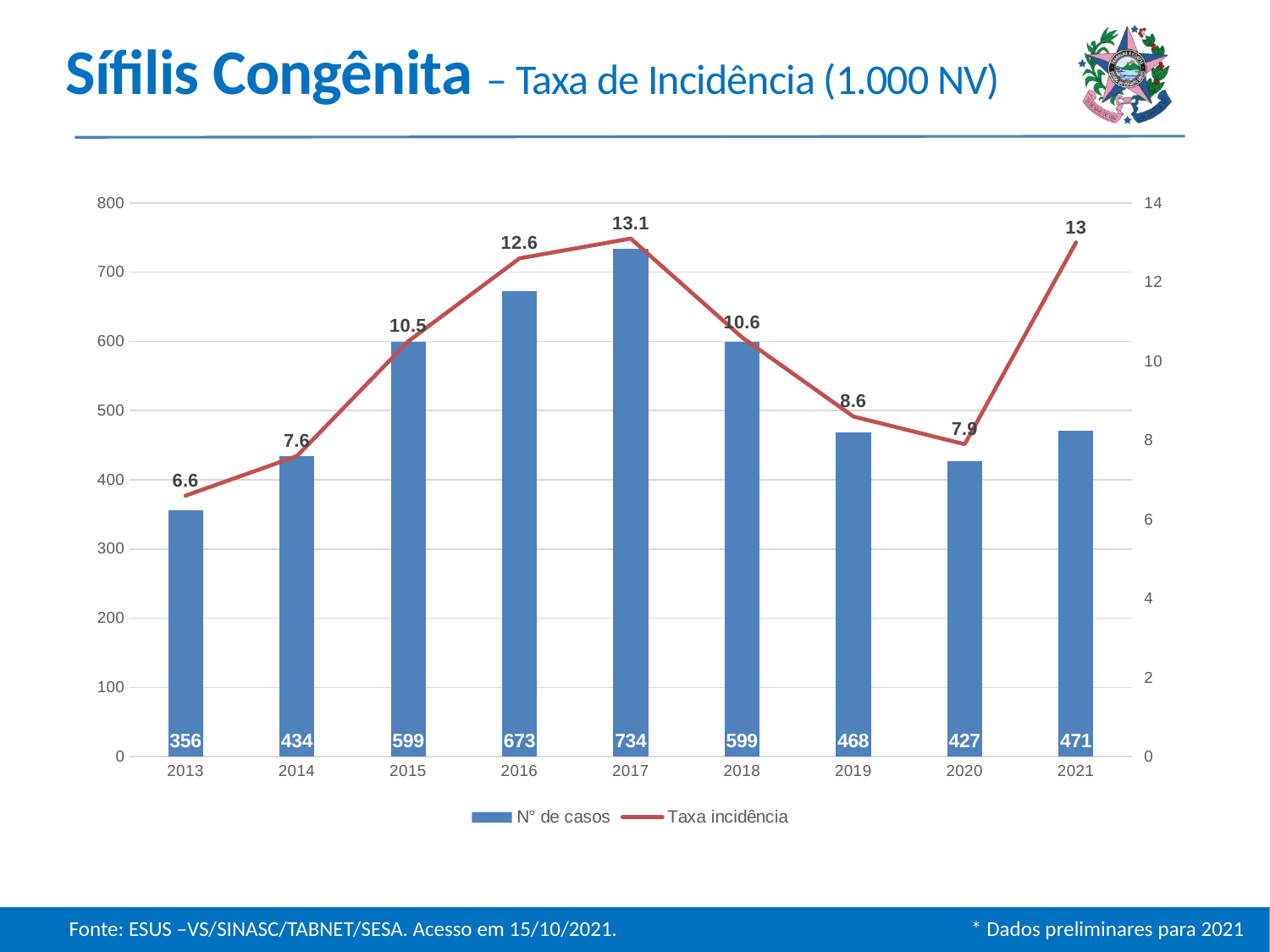
Which year has the highest number of cases? 2017 Which year has the lowest incidence rate? 2013 What is the incidence rate (Taxa incidência) in 2016? 12.6 Does the incidence rate rise or fall from 2017 to 2020? fall Which year has more cases, 2016 or 2018? 2016 What is the number of cases in 2020? 427 How many years are shown on the x axis? 9 What kind of chart is used for the N° de casos series? bar chart What colour is the Taxa incidência line? red What is the difference in number of cases between 2017 and 2013? 378 What is the number of cases (N° de casos) in 2017? 734 How many series does the legend list? 2